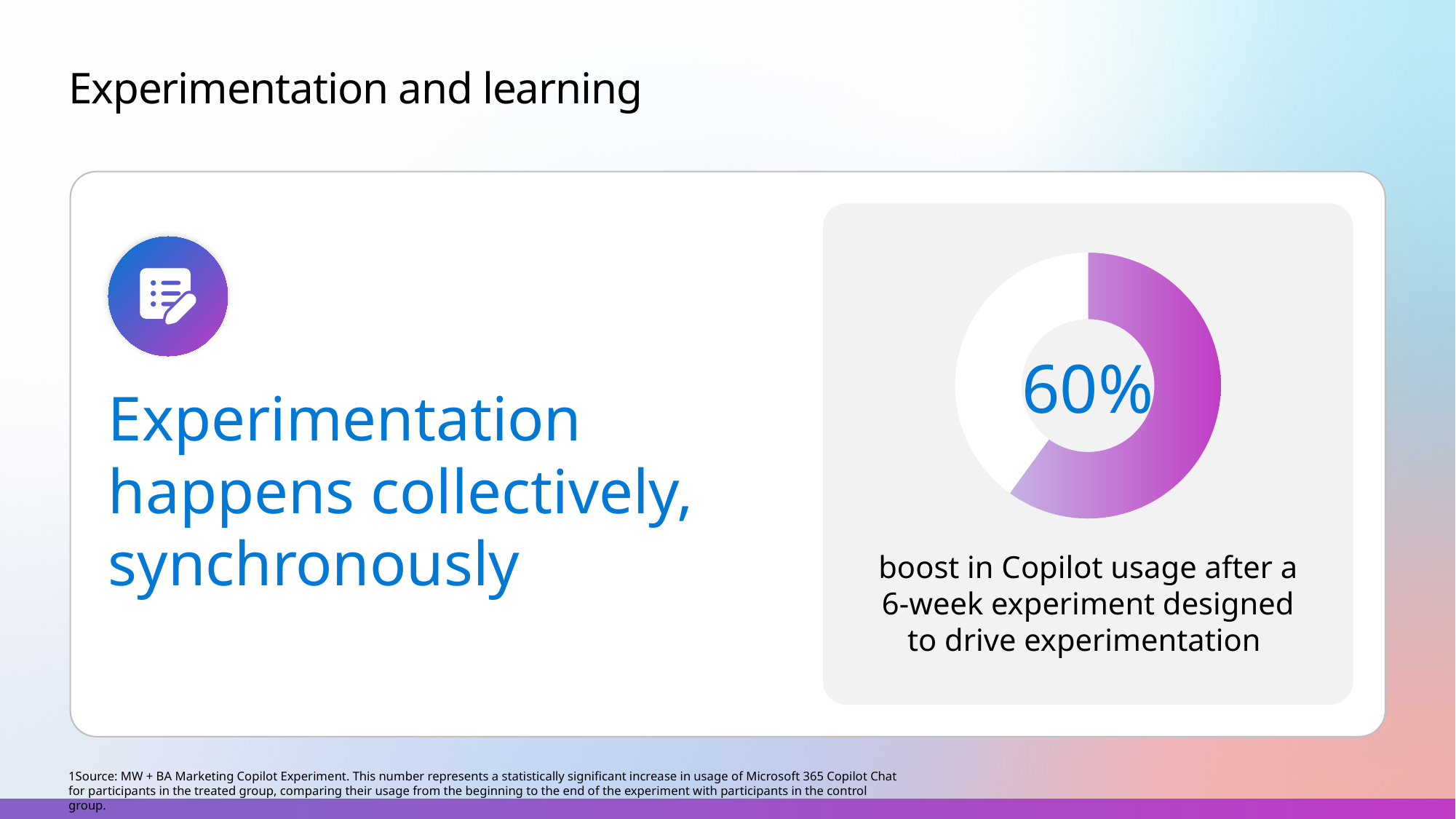
What colour is the filled segment of the donut chart? Purple/magenta Which segment of the donut chart is larger, the coloured one or the white one? The coloured one What kind of chart is shown on the slide? Donut (pie) chart What share of the donut chart is left unfilled (white)? 40% What share of the donut chart is filled by the coloured segment? 60% What does the 60% in the donut chart represent, according to the caption below it? Boost in Copilot usage after a 6-week experiment designed to drive experimentation What percentage is printed in the centre of the donut chart? 60% How many segments does the donut chart have? 2 Is the filled portion of the donut chart greater or less than 50%? greater